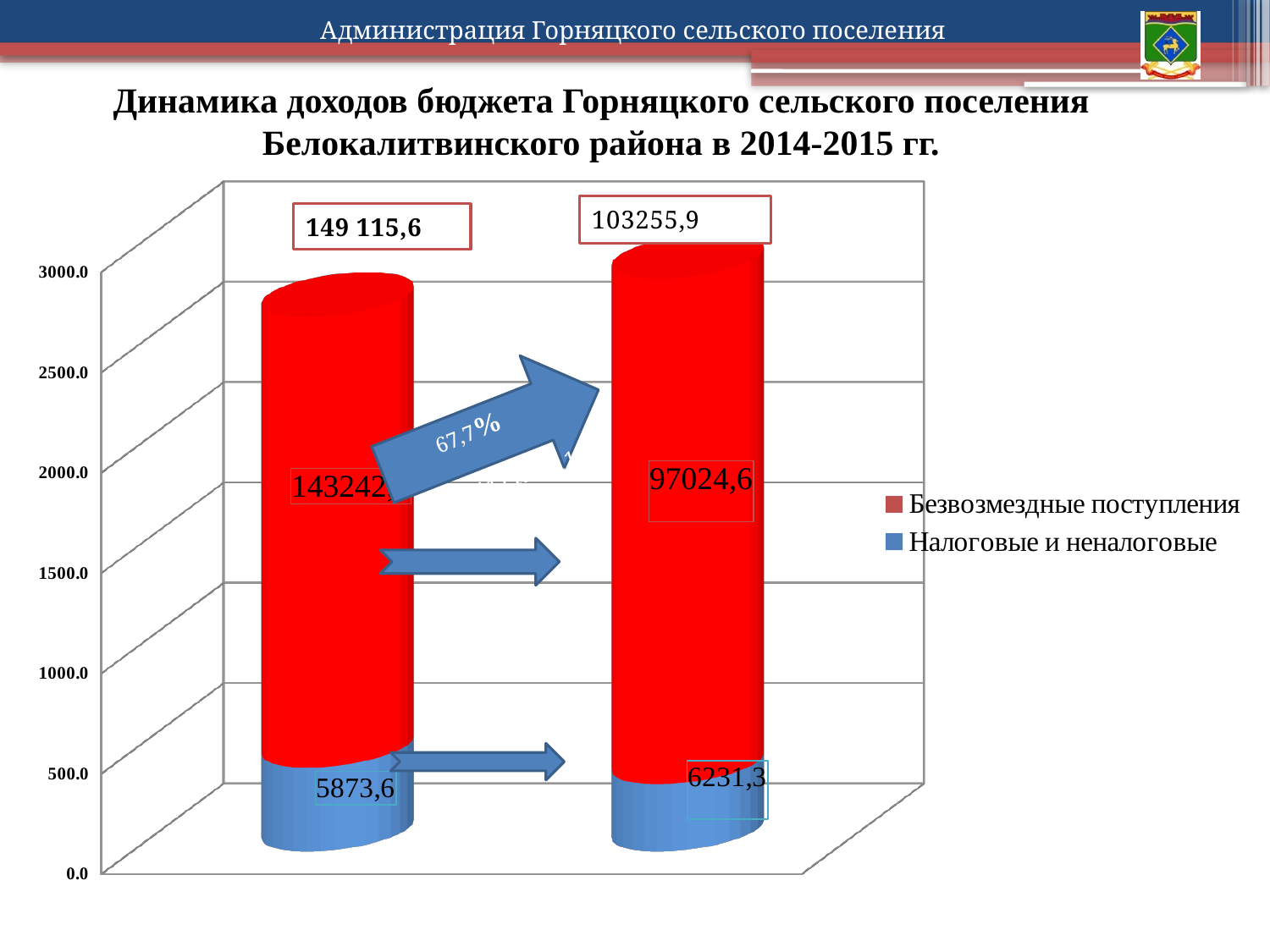
How many stacked bars are plotted in the chart? 2 What is the value of the Налоговые и неналоговые segment on the left bar? 5873,6 What percentage is written on the large arrow between the two bars? 67,7% What is the value of the Безвозмездные поступления segment on the right bar? 97024,6 What kind of chart is shown on the slide? bar chart What is the value of the Налоговые и неналоговые segment on the right bar? 6231,3 What is the difference between the Налоговые и неналоговые values of the right bar and the left bar? 357,7 What total is shown in the box above the right bar? 103255,9 Which bar has the larger Налоговые и неналоговые value, the left or the right? right Which colour represents Безвозмездные поступления in the chart? red What total is shown in the box above the left bar? 149 115,6 How many series does the legend list? 2